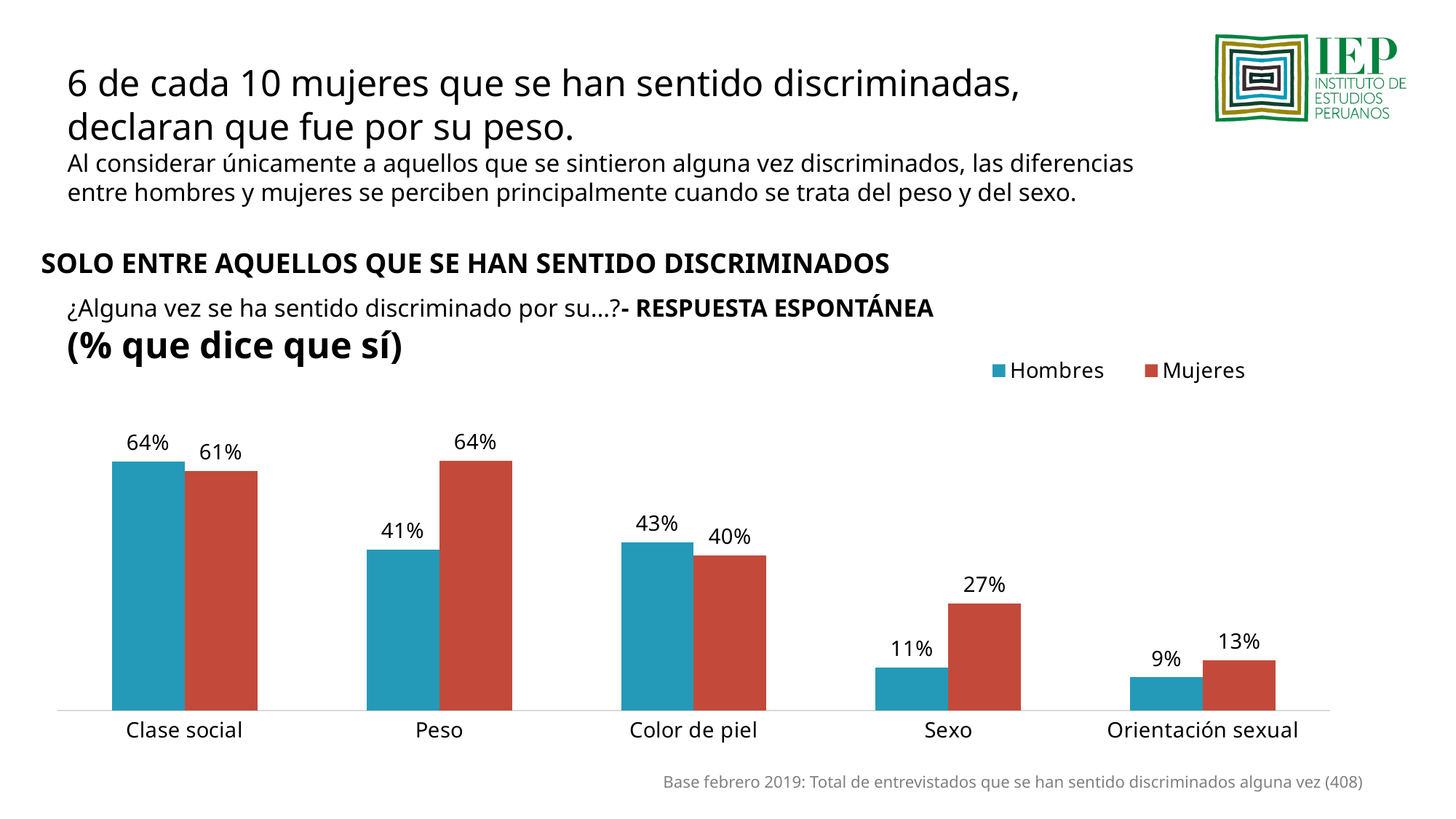
Which category has the lowest value for Hombres? Orientación sexual What is the value for Mujeres in the Sexo category? 27% How many series does the legend list? 2 In the Color de piel category, which is larger, Hombres or Mujeres? Hombres How many categories are shown on the x axis? 5 What percentage of Hombres say they have felt discriminated against because of their Clase social? 64% What is the difference between Mujeres and Hombres in the Sexo category? 16 percentage points What is the difference between Mujeres and Hombres in the Peso category? 23 percentage points What is the value for Hombres in the Orientación sexual category? 9% What percentage of Mujeres say they have felt discriminated against because of their Peso? 64% What kind of chart is shown on the slide? Bar chart Which category has the highest value for Mujeres? Peso